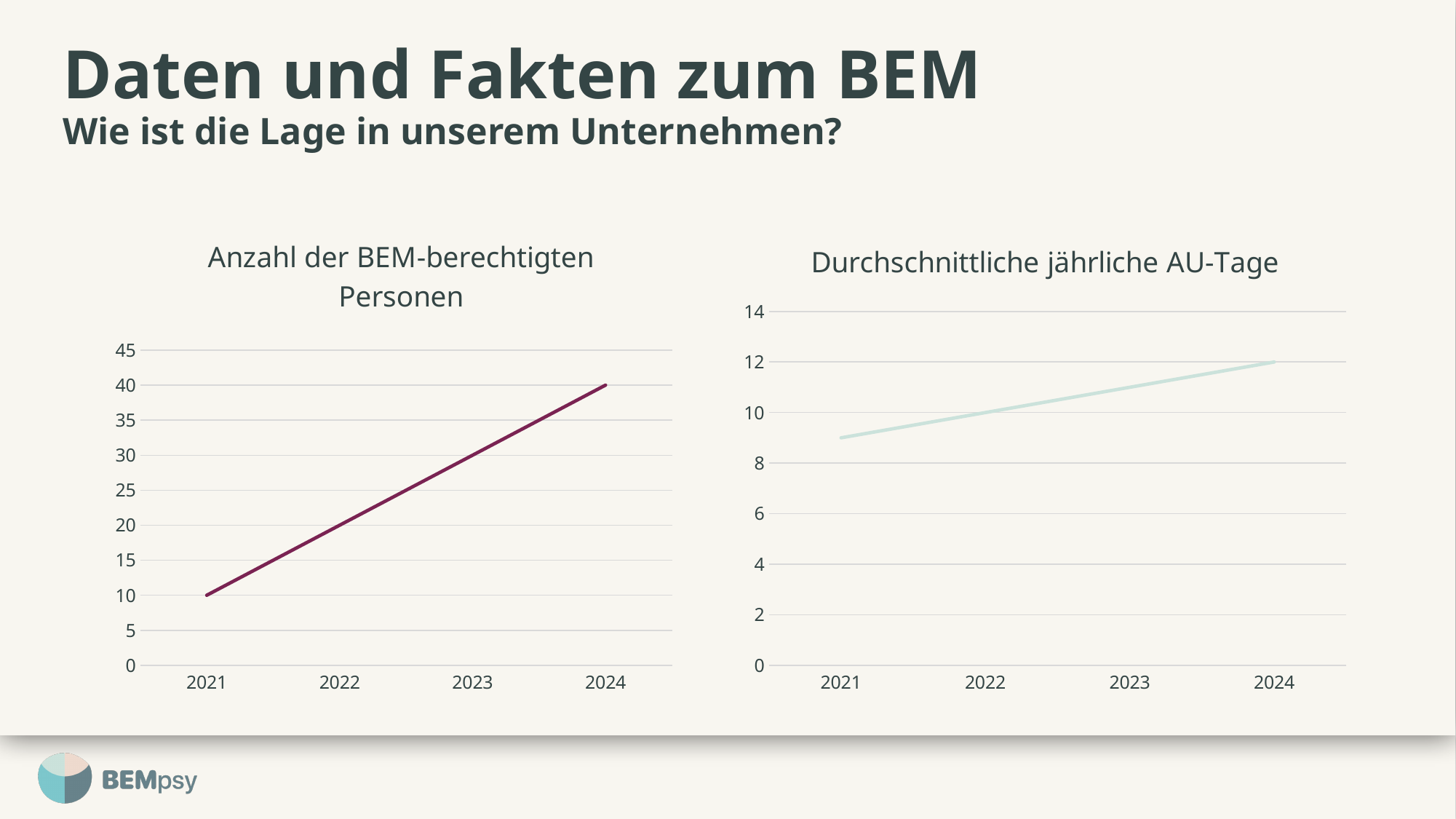
In the chart 'Anzahl der BEM-berechtigten Personen', do the values rise or fall from 2021 to 2024? rise In the chart 'Durchschnittliche jährliche AU-Tage', do the values rise or fall from 2021 to 2024? rise What is the title of the right chart on the slide? Durchschnittliche jährliche AU-Tage In the chart 'Anzahl der BEM-berechtigten Personen', what is the value for 2024? 40 How many years are shown on the x axis of the chart 'Anzahl der BEM-berechtigten Personen'? 4 In the chart 'Durchschnittliche jährliche AU-Tage', is the value for 2021 greater or less than 10? less In the chart 'Anzahl der BEM-berechtigten Personen', is the value for 2023 greater or less than 35? less In the chart 'Anzahl der BEM-berechtigten Personen', is the value for 2022 greater or less than 15? greater In the chart 'Durchschnittliche jährliche AU-Tage', what is the value for 2024? 12 What kind of chart is the left chart, 'Anzahl der BEM-berechtigten Personen'? line chart In the chart 'Anzahl der BEM-berechtigten Personen', which year has the highest value? 2024 In the chart 'Anzahl der BEM-berechtigten Personen', what is the value for 2021? 10